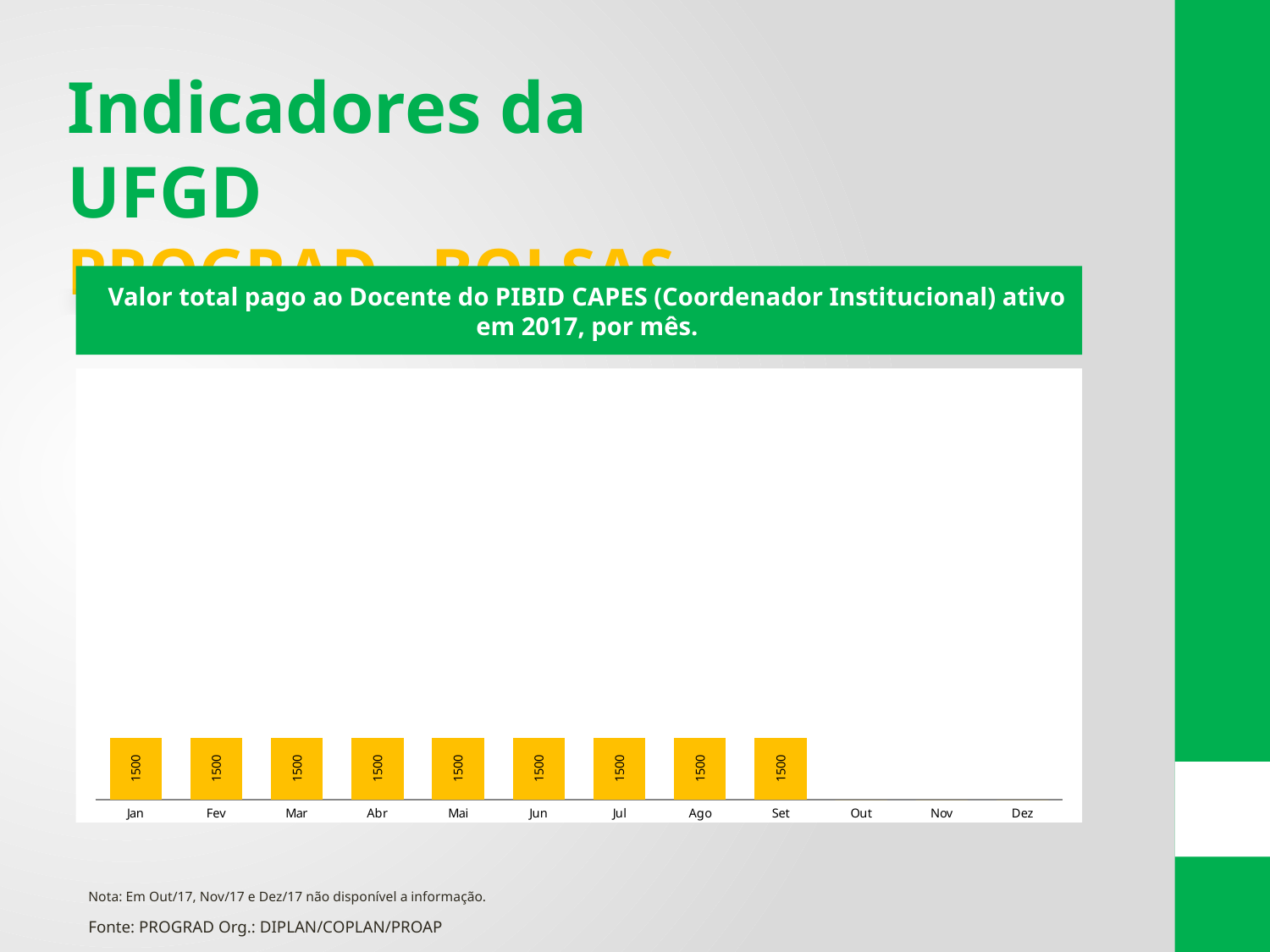
What is the difference between the values for Mar and Jul? 0 What colour are the bars? yellow What is the value for Mai? 1500 Which months have no bar plotted? Out, Nov, Dez Is the value for Fev greater or less than the value for Jun, or are they equal? equal Do the values rise, fall or stay flat from Jan to Set? stay flat How many months are labelled on the x axis? 12 What kind of chart is shown? bar chart What is the value for Jan? 1500 How many months have a bar plotted? 9 What is the value for Ago? 1500 What is the value for Set? 1500